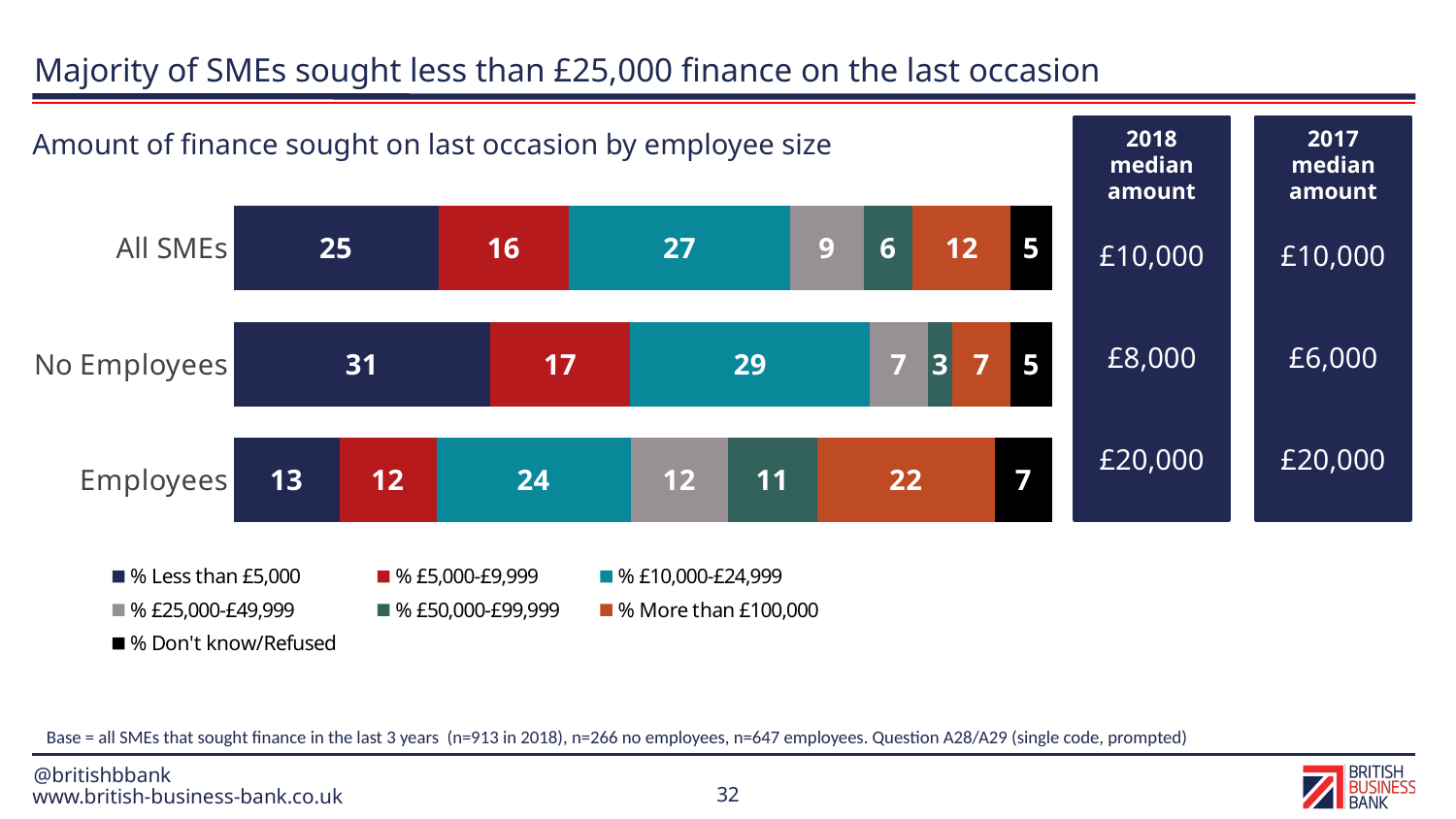
Which category has the highest value for % Less than £5,000? No Employees What is the total of the stacked bar for All SMEs? 100 What kind of chart is shown on the slide? Stacked bar chart How many employee-size categories are plotted in the chart? 3 What is the value for % Less than £5,000 for No Employees? 31 What is the difference between the % £10,000-£24,999 values for No Employees and Employees? 5 How many series does the chart legend list? 7 What is the value for % More than £100,000 for Employees? 22 Which category has the lowest value for % £50,000-£99,999? No Employees Which is larger: the % £25,000-£49,999 value for Employees or for All SMEs? Employees What is the title of the chart? Amount of finance sought on last occasion by employee size What is the value for % £10,000-£24,999 for All SMEs? 27